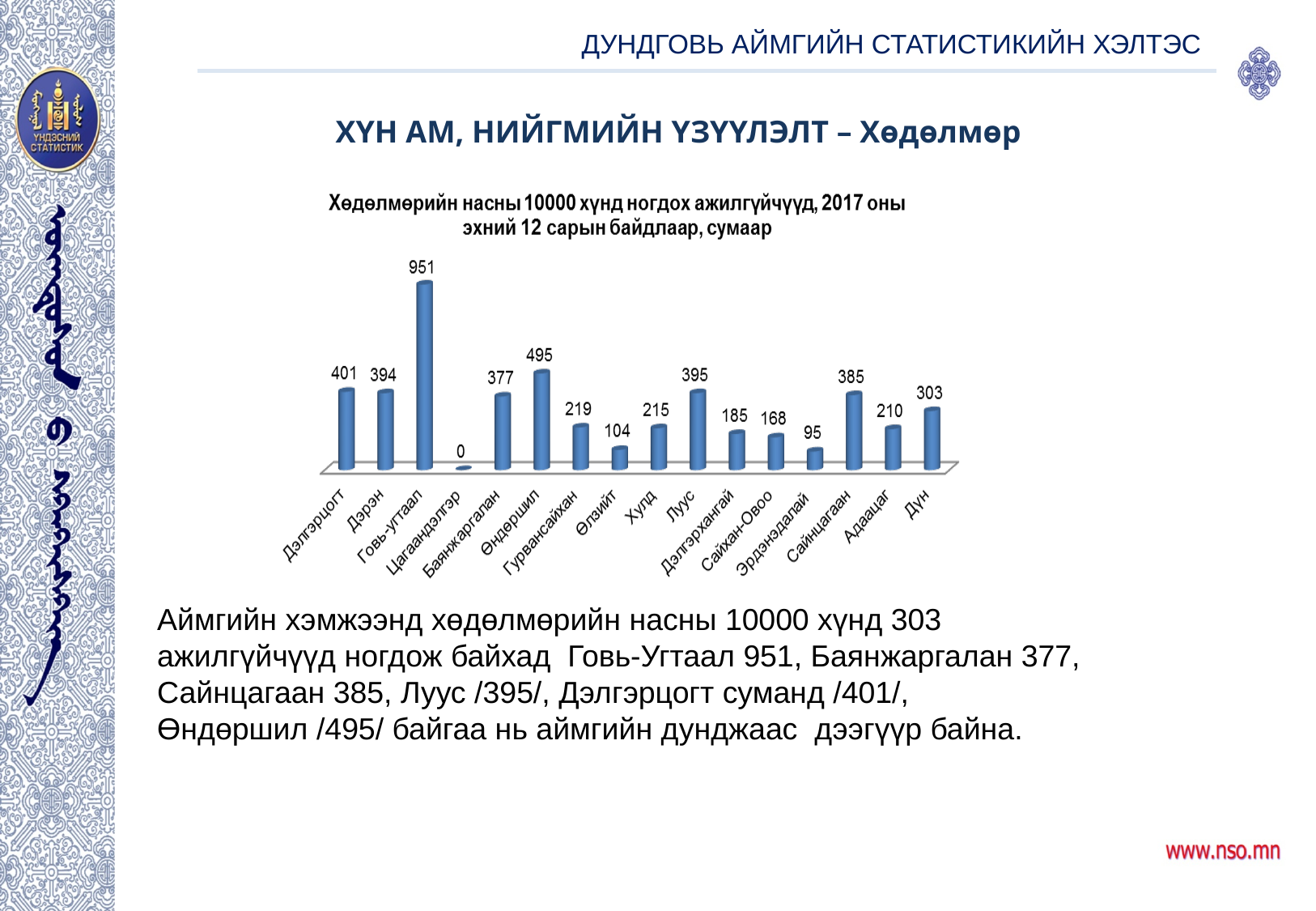
What is the value for Эрдэнэдалай? 95 What is the value for Цагаандэлгэр? 0 What is the value for Дүн? 303 What kind of chart is shown on the slide? Bar chart What is the value for Говь-Угтаал? 951 How many categories are shown on the x axis? 16 What is the difference between the values for Өндөршил and Дэлгэрцогт? 94 What is the value for Өндөршил? 495 Which category has the lowest value? Цагаандэлгэр Which category has the highest value? Говь-Угтаал Which is larger, the value for Сайнцагаан or the value for Адаацаг? Сайнцагаан What is the difference between the values for Говь-Угтаал and Дүн? 648